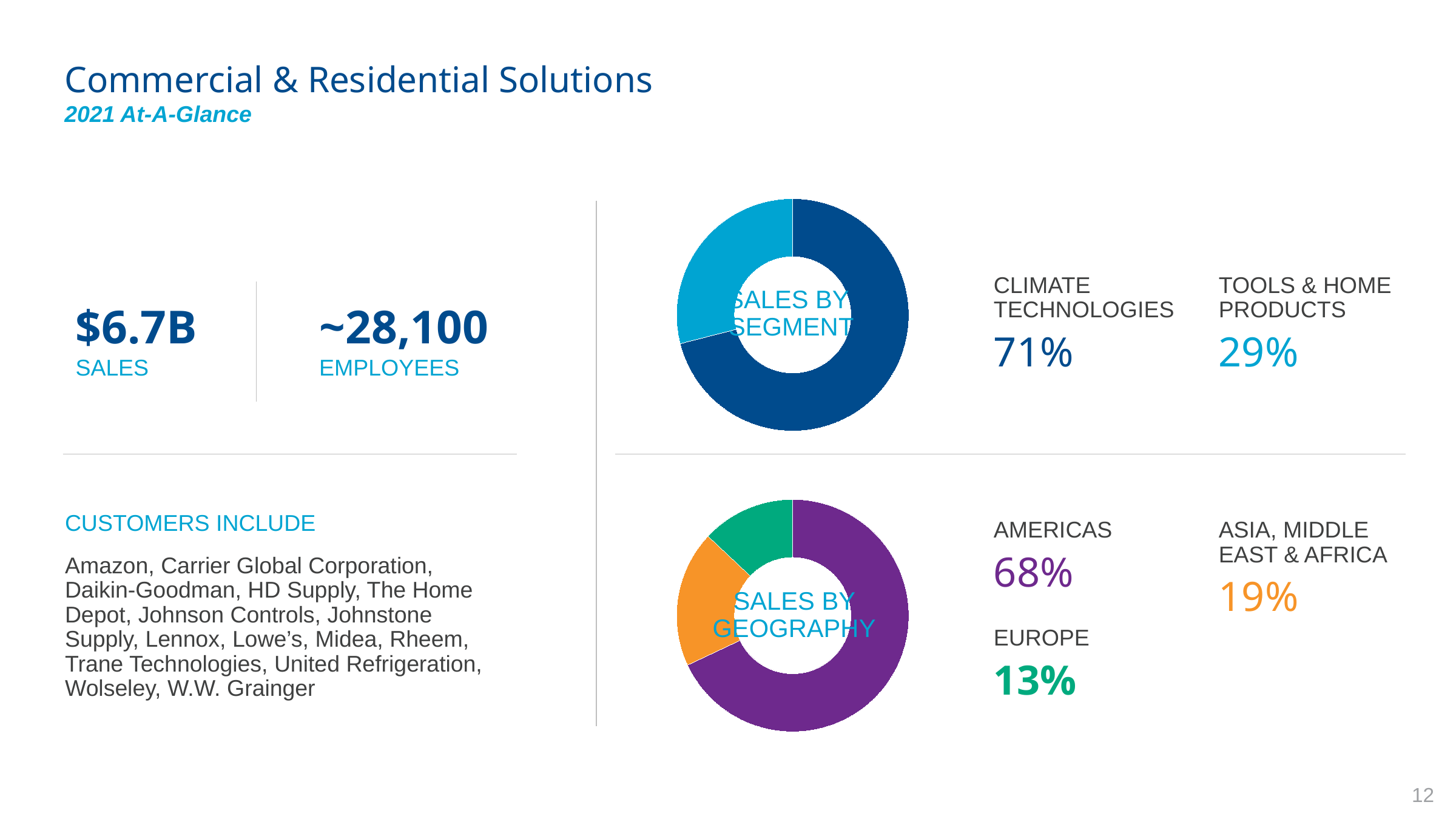
In the Sales by Segment chart, what share of sales comes from Climate Technologies? 71% In the Sales by Segment chart, which segment has the larger share? Climate Technologies In the Sales by Geography chart, what share of sales comes from the Americas? 68% In the Sales by Geography chart, which region has the smallest share? Europe In the Sales by Segment chart, what share of sales comes from Tools & Home Products? 29% What kind of chart is the Sales by Geography chart? Doughnut chart In the Sales by Geography chart, what share of sales comes from Asia, Middle East & Africa? 19% How many segments are shown in the Sales by Segment chart? 2 In the Sales by Segment chart, what is the difference in percentage points between Climate Technologies and Tools & Home Products? 42 In the Sales by Geography chart, what share of sales comes from Europe? 13% How many regions are shown in the Sales by Geography chart? 3 In the Sales by Geography chart, which is larger: Europe or Asia, Middle East & Africa? Asia, Middle East & Africa